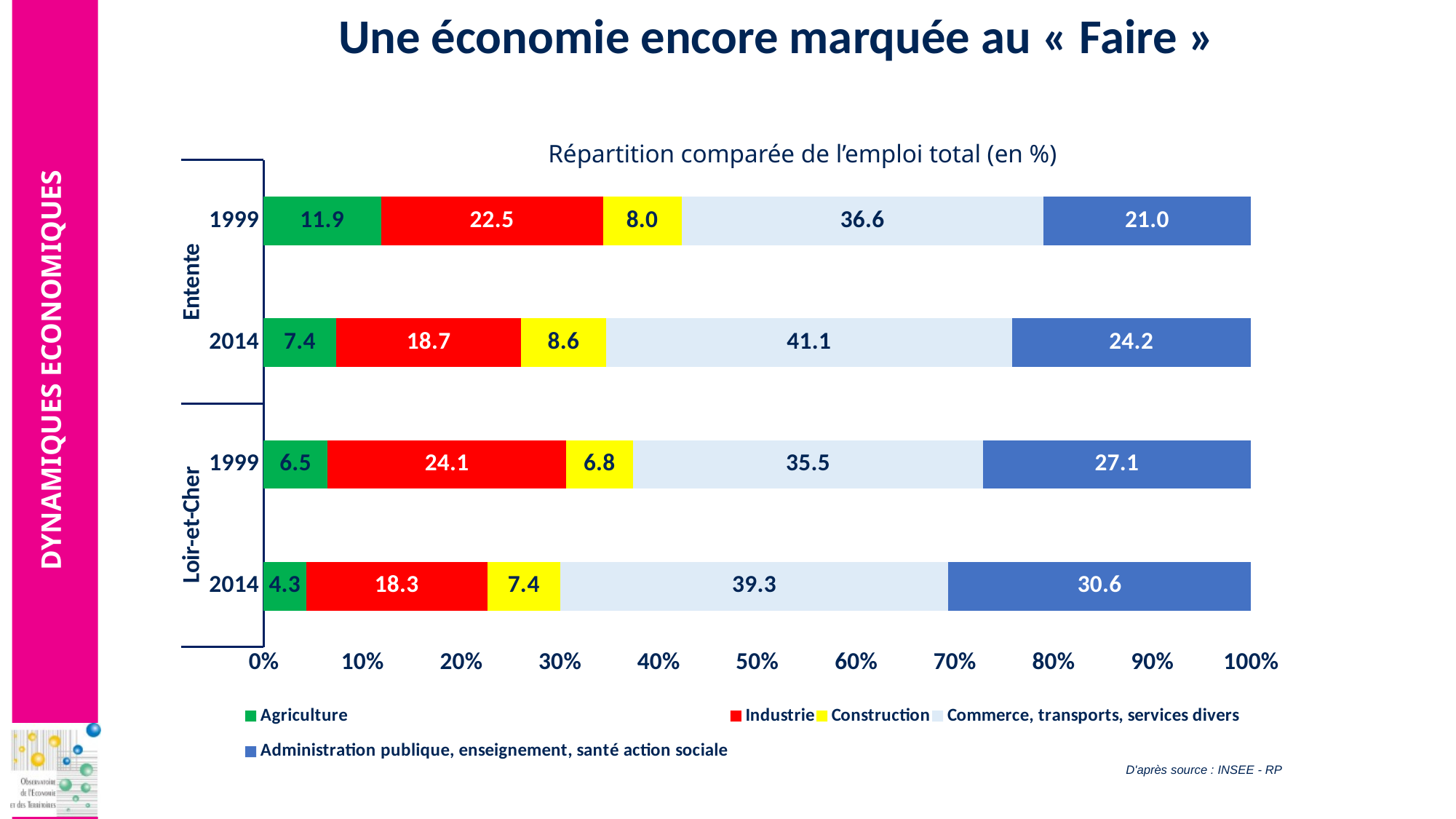
What is the Industrie share for Loir-et-Cher in 2014? 18.3 By how many points did the Industrie share for Entente fall between 1999 and 2014? 3.8 Which of the four bars has the lowest Construction value? Loir-et-Cher 1999 What is the value of Commerce, transports, services divers for Entente in 2014? 41.1 What type of chart is shown on the slide? Stacked bar chart Which of the four bars has the highest Agriculture value? Entente 1999 How many series does the legend list? 5 How many bars are plotted in the chart? 4 What is the Administration publique, enseignement, santé action sociale share for Loir-et-Cher in 1999? 27.1 What is the Agriculture share for Entente in 1999? 11.9 What is the title of the chart? Répartition comparée de l'emploi total (en %) Which is larger: the Administration publique share for Entente in 2014 or for Loir-et-Cher in 2014? Loir-et-Cher 2014